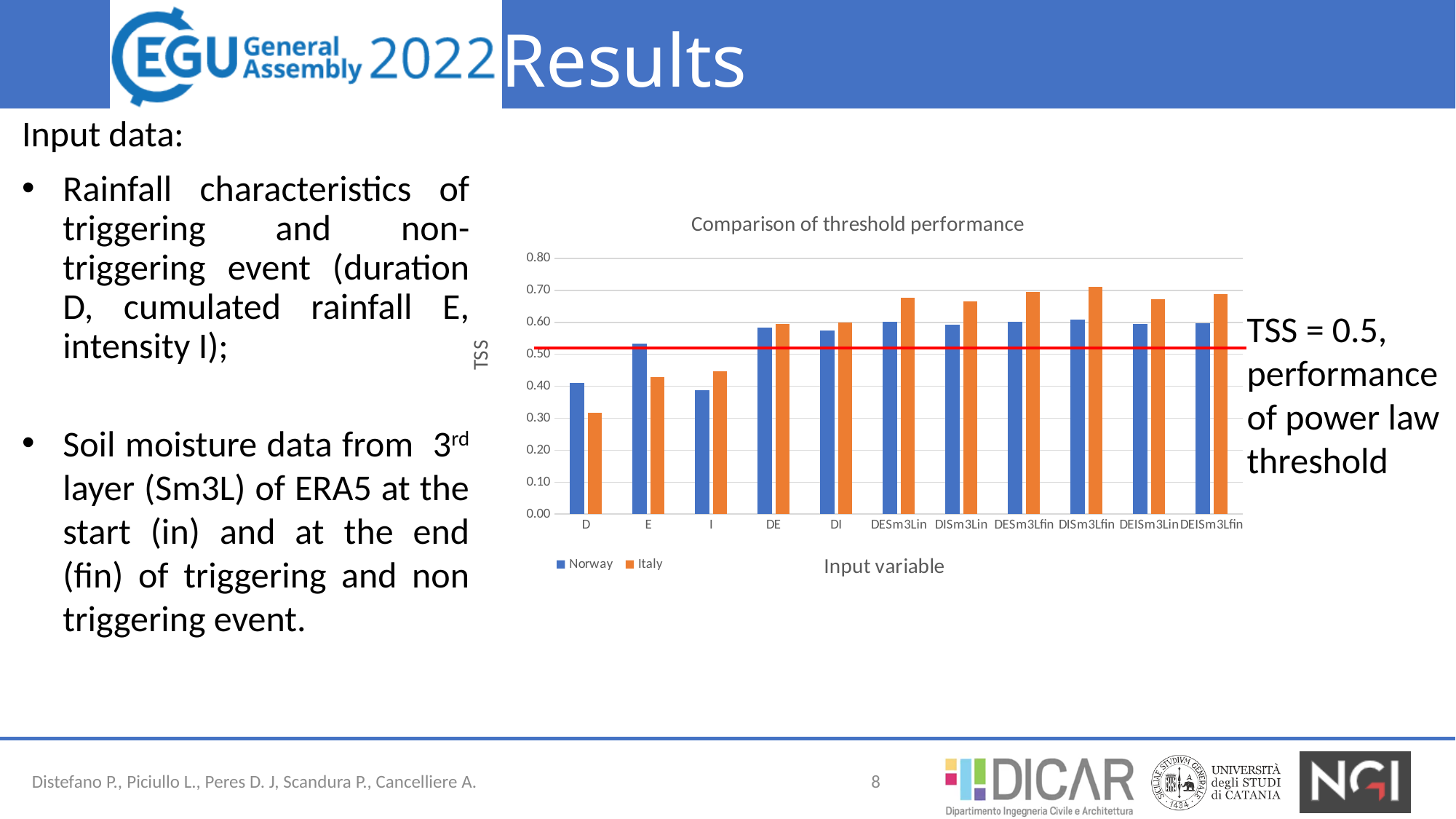
How many series does the legend of the chart list? 2 How many input variable categories are shown on the x axis of the chart? 11 What are the two series named in the chart legend? Norway and Italy What is the title of the chart? Comparison of threshold performance Is the Italy value for DISm3Lin greater or less than 0.70? less For input variable DESm3Lin, which series has the larger value, Norway or Italy? Italy What kind of chart is shown on the slide? bar chart For which input variable is the Italy value lowest? D Is the Norway value for E greater or less than 0.50? greater Is the Italy value for D greater or less than 0.40? less For input variable D, which series has the larger value, Norway or Italy? Norway